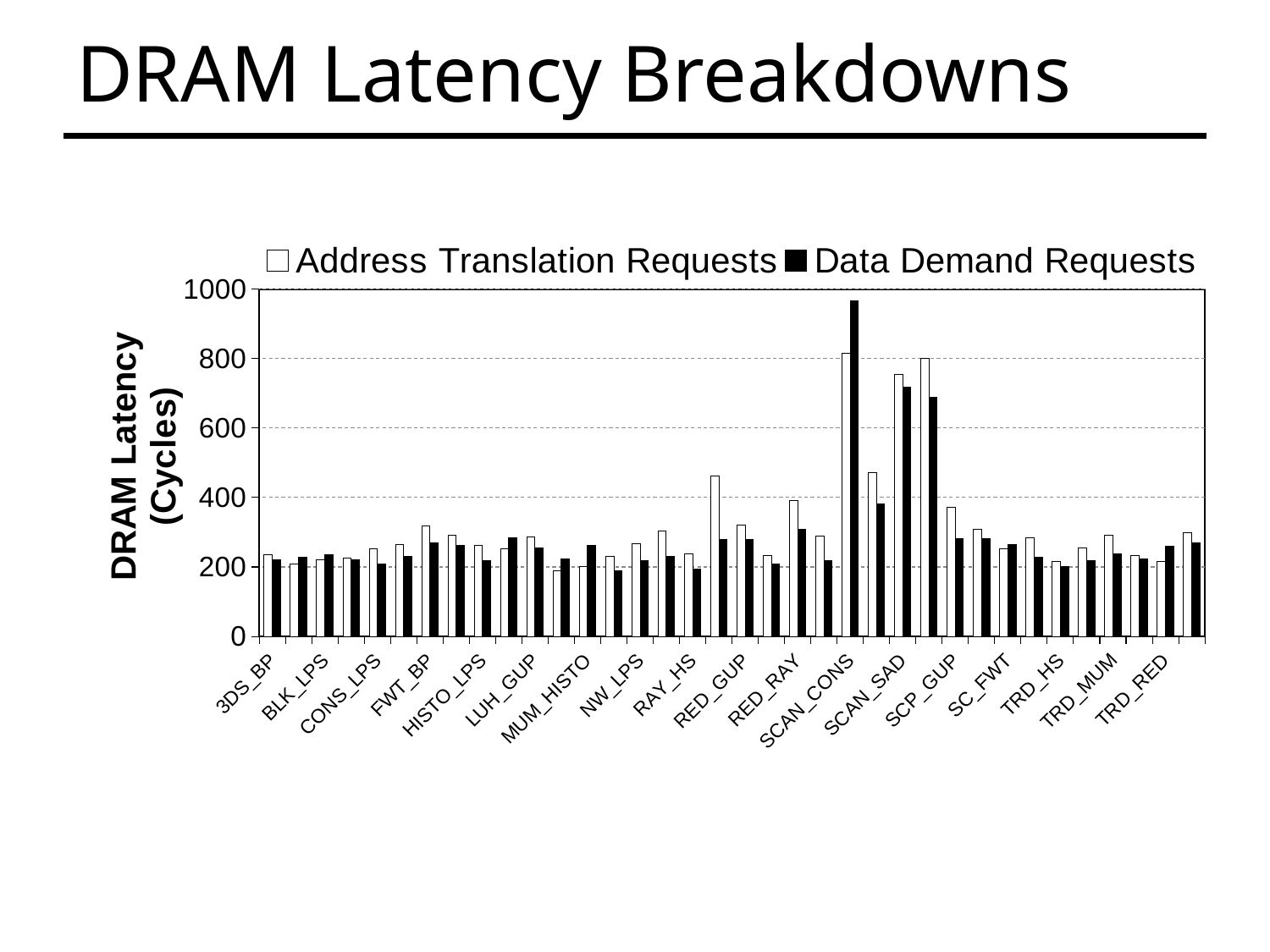
What are the two series named in the legend? Address Translation Requests and Data Demand Requests For SCAN_CONS, which series has the larger value, Address Translation Requests or Data Demand Requests? Data Demand Requests What kind of chart is shown on the slide? bar chart Which category has the highest Data Demand Requests latency? SCAN_CONS How many series does the legend list? 2 Is the Address Translation Requests value for 3DS_BP greater or less than 400? less What is the label of the y axis? DRAM Latency (Cycles) Is the Data Demand Requests value for SCAN_CONS greater or less than 800? greater Is the Data Demand Requests value for 3DS_BP greater or less than 400? less Which series contains the tallest bar in the chart? Data Demand Requests